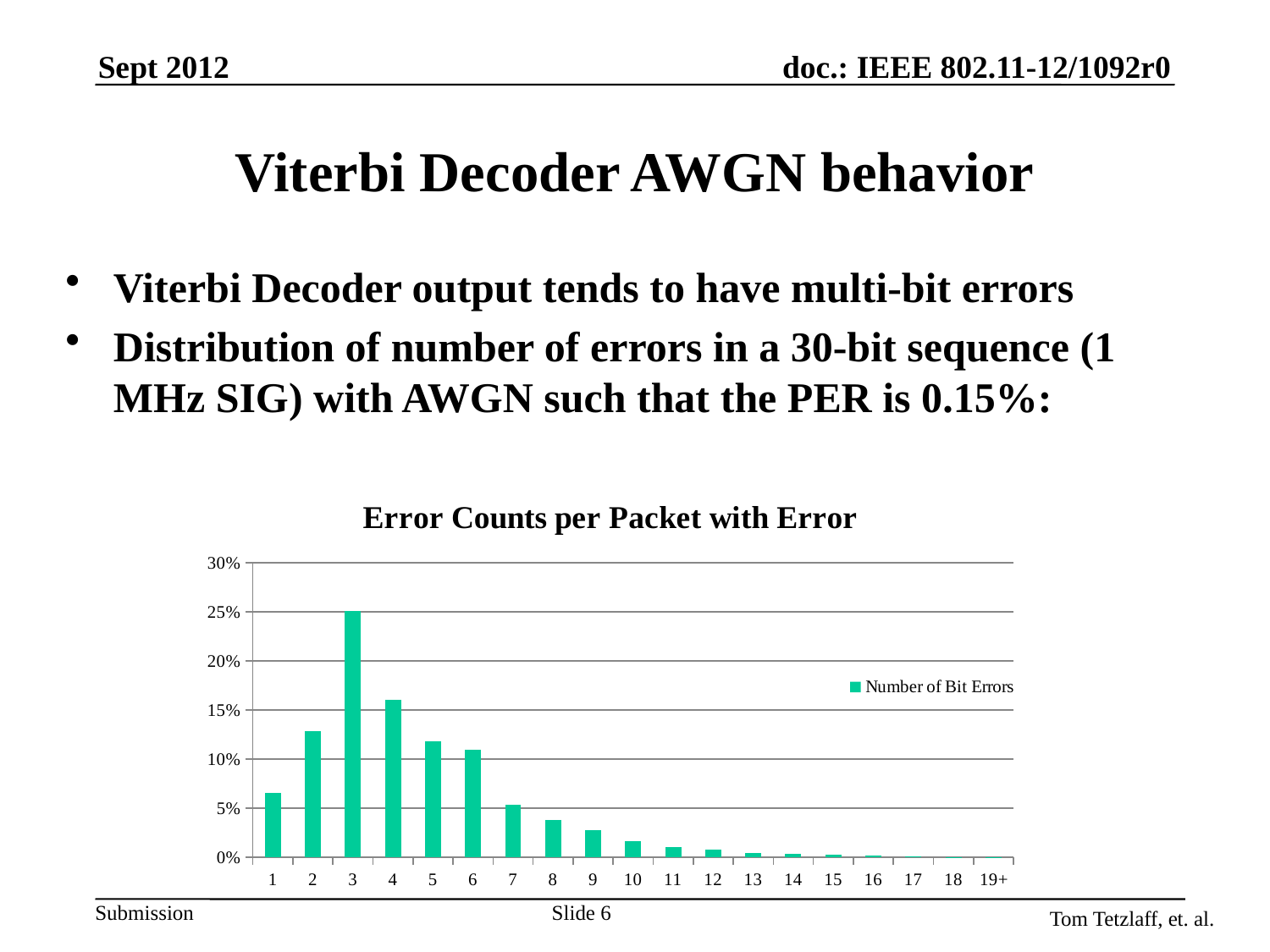
Do the values rise or fall from category 3 to category 19+? fall What is the title of the chart? Error Counts per Packet with Error Is the value for category 4 greater or less than 15%? greater Which has the larger value, category 2 or category 4? 4 Is the value for category 1 greater or less than 5%? greater Which category has the highest value? 3 Is the value for category 8 greater or less than 5%? less What series name does the chart legend list? Number of Bit Errors What kind of chart is shown on the slide? bar chart How many categories are shown along the x axis? 19 How many series does the legend list? 1